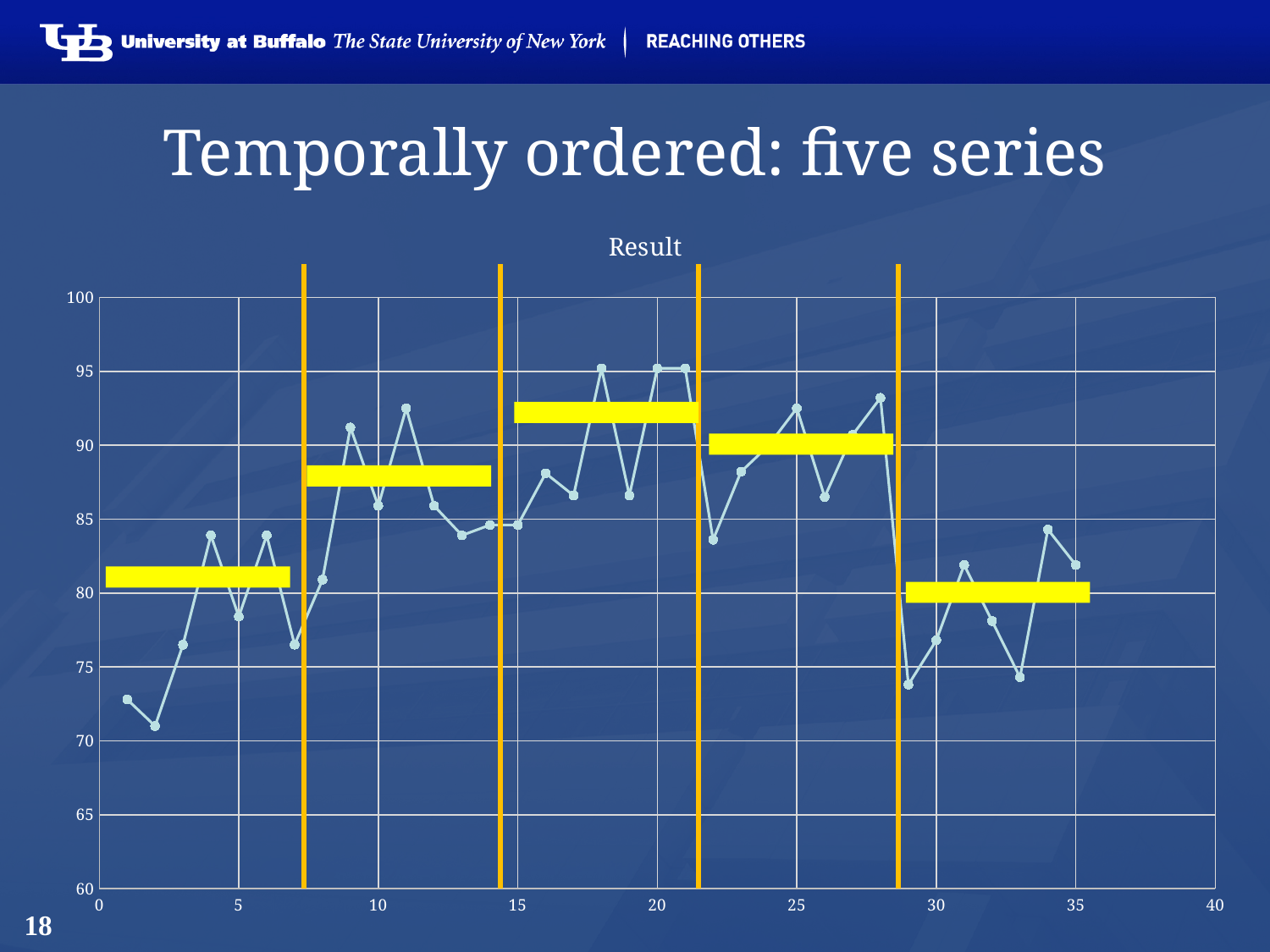
At which x value does the lowest point in the chart occur? 2 Is the value at x = 18 greater or less than 90? greater How many vertical orange divider lines separate the series in the chart? 4 Is the value at x = 11 greater or less than 90? greater Which has the larger value, the point at x = 9 or the point at x = 29? x = 9 Is the value at x = 29 greater or less than 75? less What kind of chart is shown on the slide? line chart What is the title of the chart? Result How many data points are plotted in the chart? 35 Which has the larger value, the point at x = 2 or the point at x = 18? x = 18